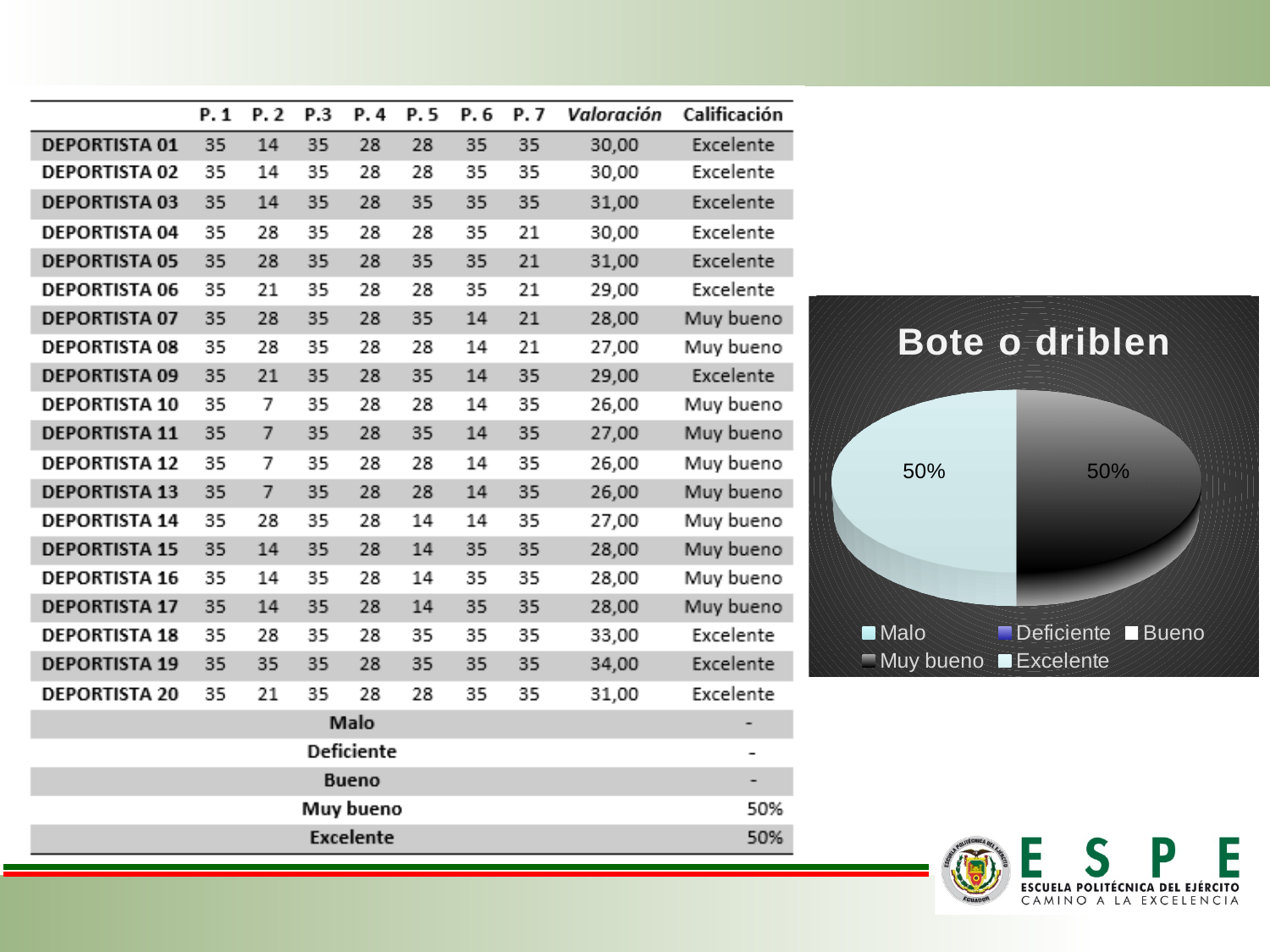
How many slices are visible in the pie chart? 2 What kind of chart is shown on the slide? pie chart What share of the pie chart does the Muy bueno slice represent? 50% Is the share for Muy bueno greater or less than 25%? greater What share of the pie chart does the Excelente slice represent? 50% What is the title of the pie chart? Bote o driblen What is the combined share of the Muy bueno and Excelente slices? 100% How many entries does the legend of the pie chart list? 5 Is the Excelente slice larger, smaller, or the same size as the Muy bueno slice? the same size